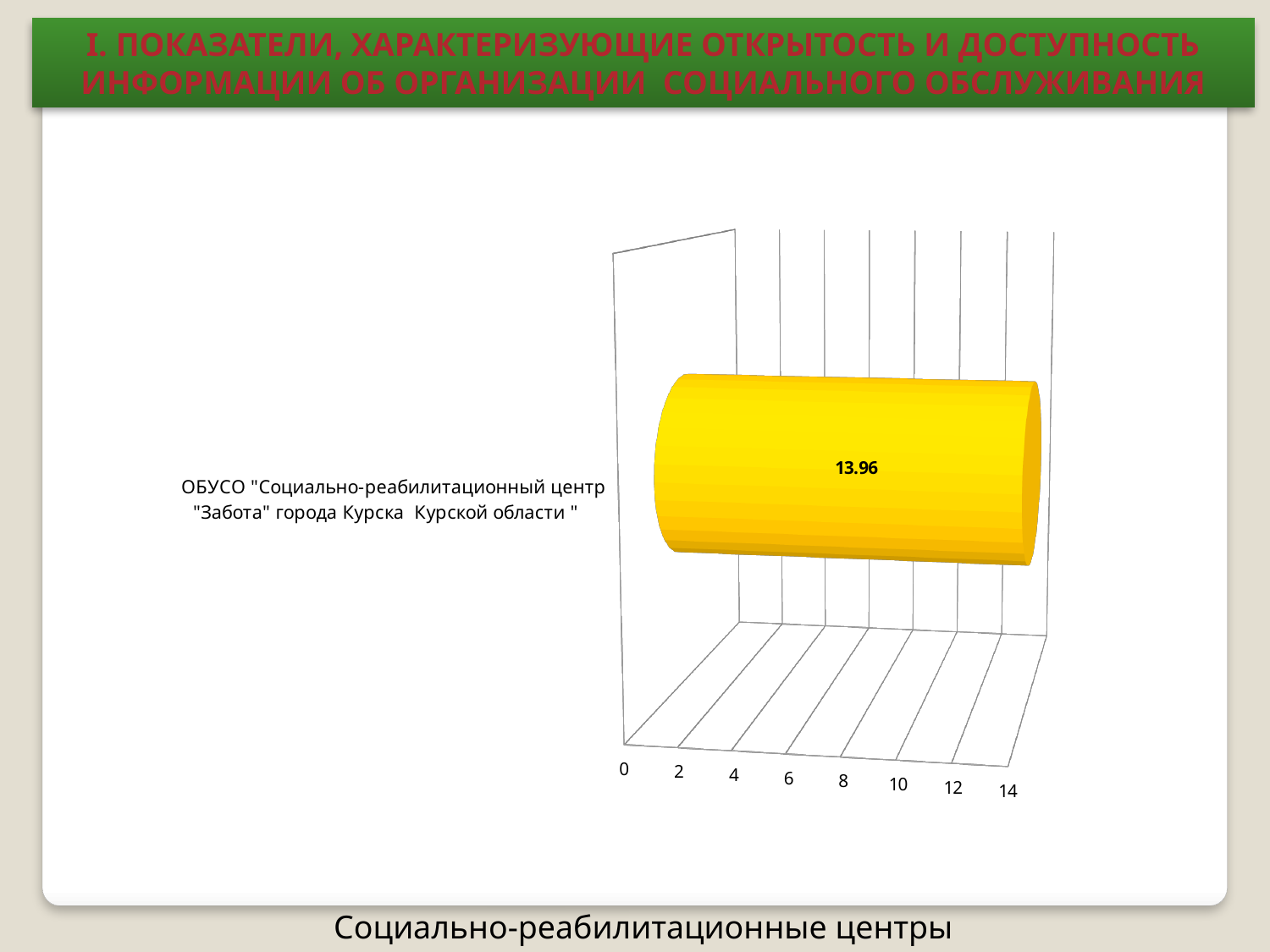
What kind of chart is shown on the slide? Bar chart What is the highest tick value shown on the value axis of the chart? 14 Is the value for ОБУСО "Социально-реабилитационный центр "Забота" greater or less than 12? greater How many categories are plotted in the chart? 1 What is the value shown for ОБУСО "Социально-реабилитационный центр "Забота" города Курска Курской области"? 13.96 Which category has the highest value in the chart? ОБУСО "Социально-реабилитационный центр "Забота" города Курска Курской области" Is the value for ОБУСО "Социально-реабилитационный центр "Забота" greater or less than 10? greater What colour is the bar in the chart? Yellow